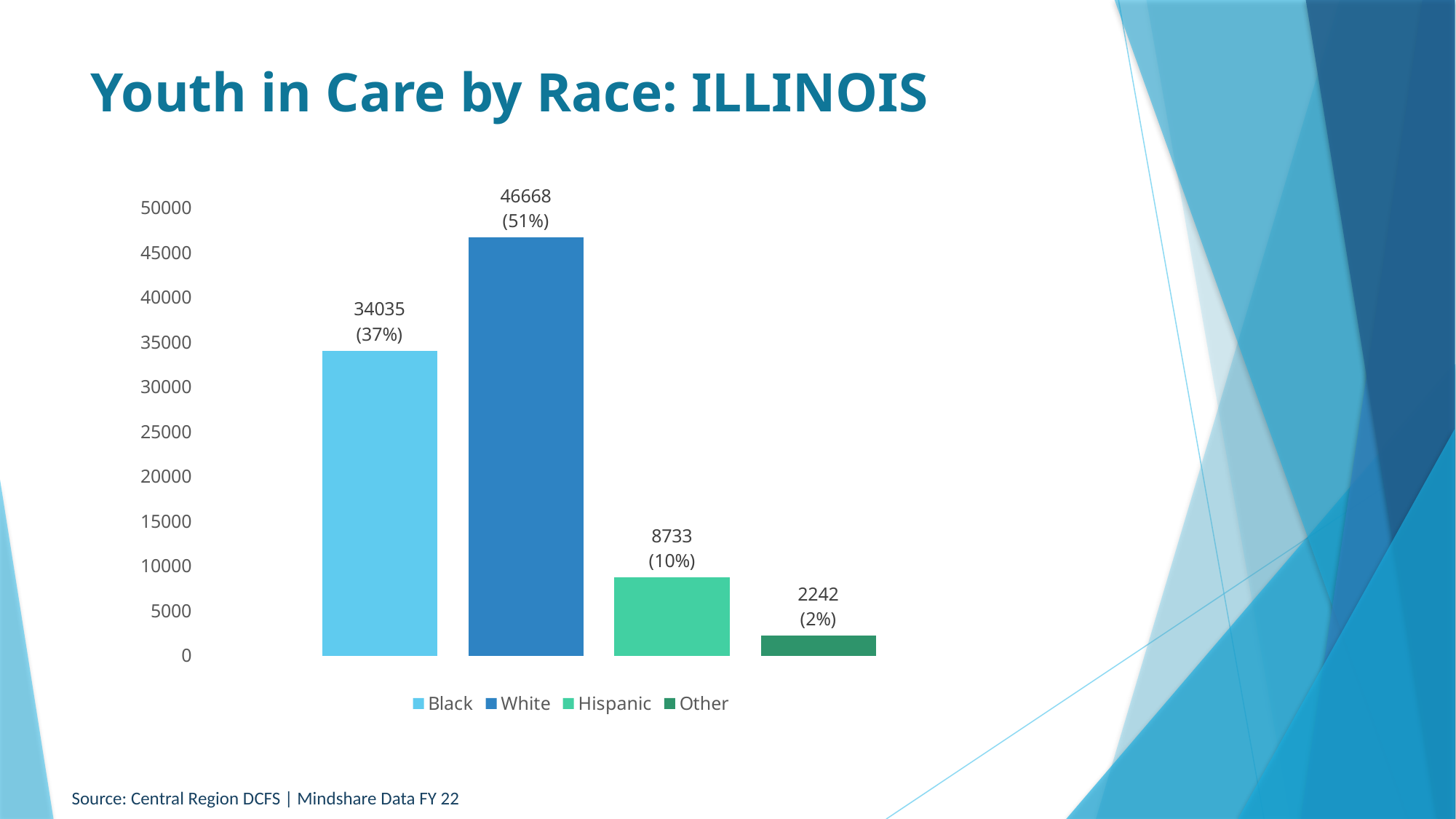
What is the title of the slide? Youth in Care by Race: ILLINOIS What kind of chart is shown on the slide? Bar chart What is the number of youth in care for the Other category? 2242 What percentage is shown for Hispanic youth in care? 10% What is the difference between the White and Black youth in care counts? 12633 Is the value for Black youth greater or less than 30000? greater Which race category has the lowest number of youth in care? Other Which is larger, the value for Hispanic or the value for Other? Hispanic Which race category has the highest number of youth in care? White How many race categories are shown in the chart? 4 What is the number of youth in care for Black youth? 34035 What is the number of youth in care for White youth? 46668